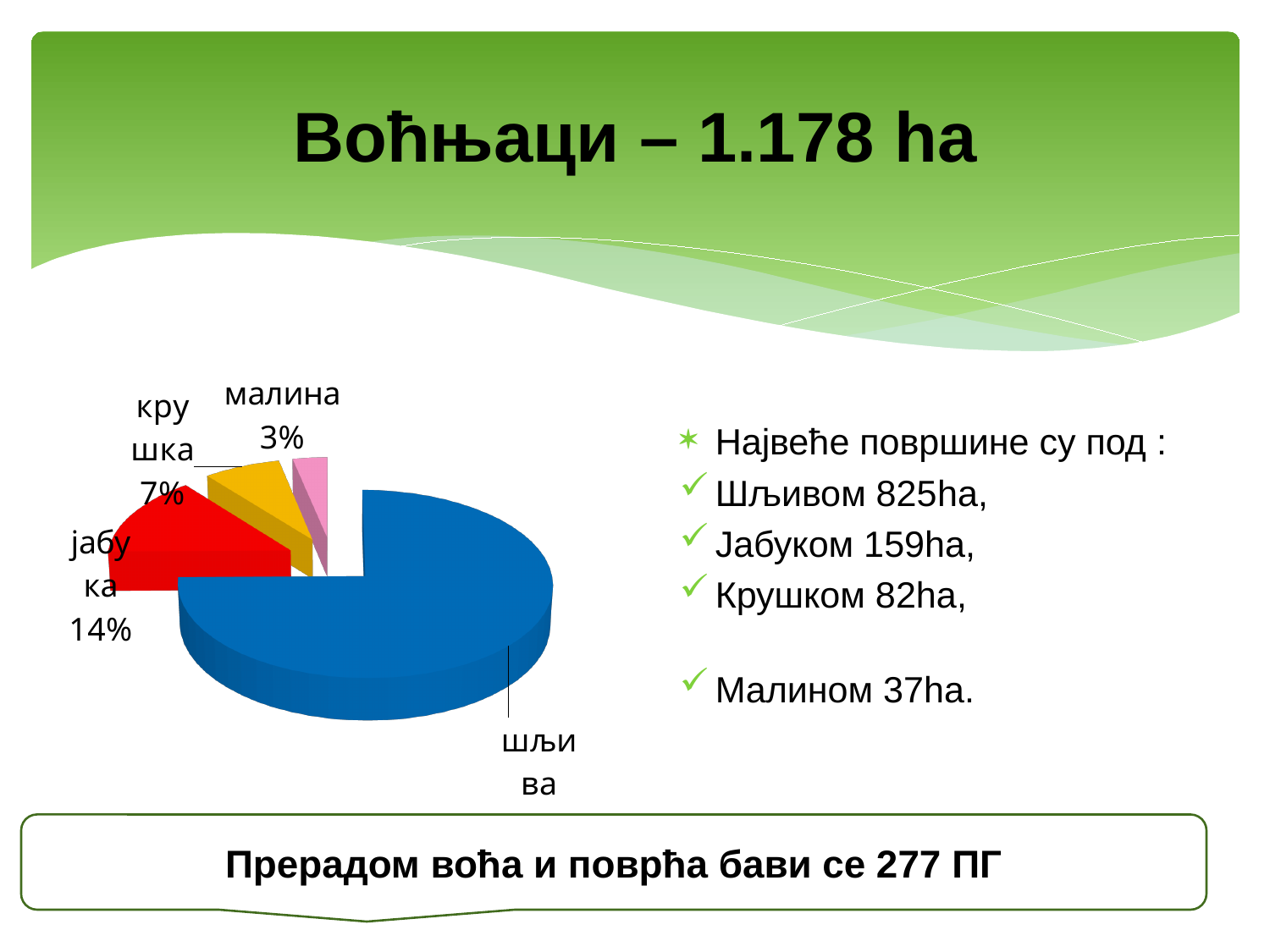
What is the difference in percentage points between the крушка and малина shares? 4% What share of the pie does малина have? 3% What colour is the шљива slice in the pie chart? blue Which has a larger share of the pie, јабука or крушка? јабука How many slices does the pie chart have? 4 Which slice of the pie chart is the largest? шљива What share of the pie does крушка have? 7% What share of the pie does јабука have? 14% What is the difference in percentage points between the јабука and крушка shares? 7% What colour is the јабука slice in the pie chart? red What kind of chart is shown on the slide? pie chart Which slice of the pie chart is the smallest? малина